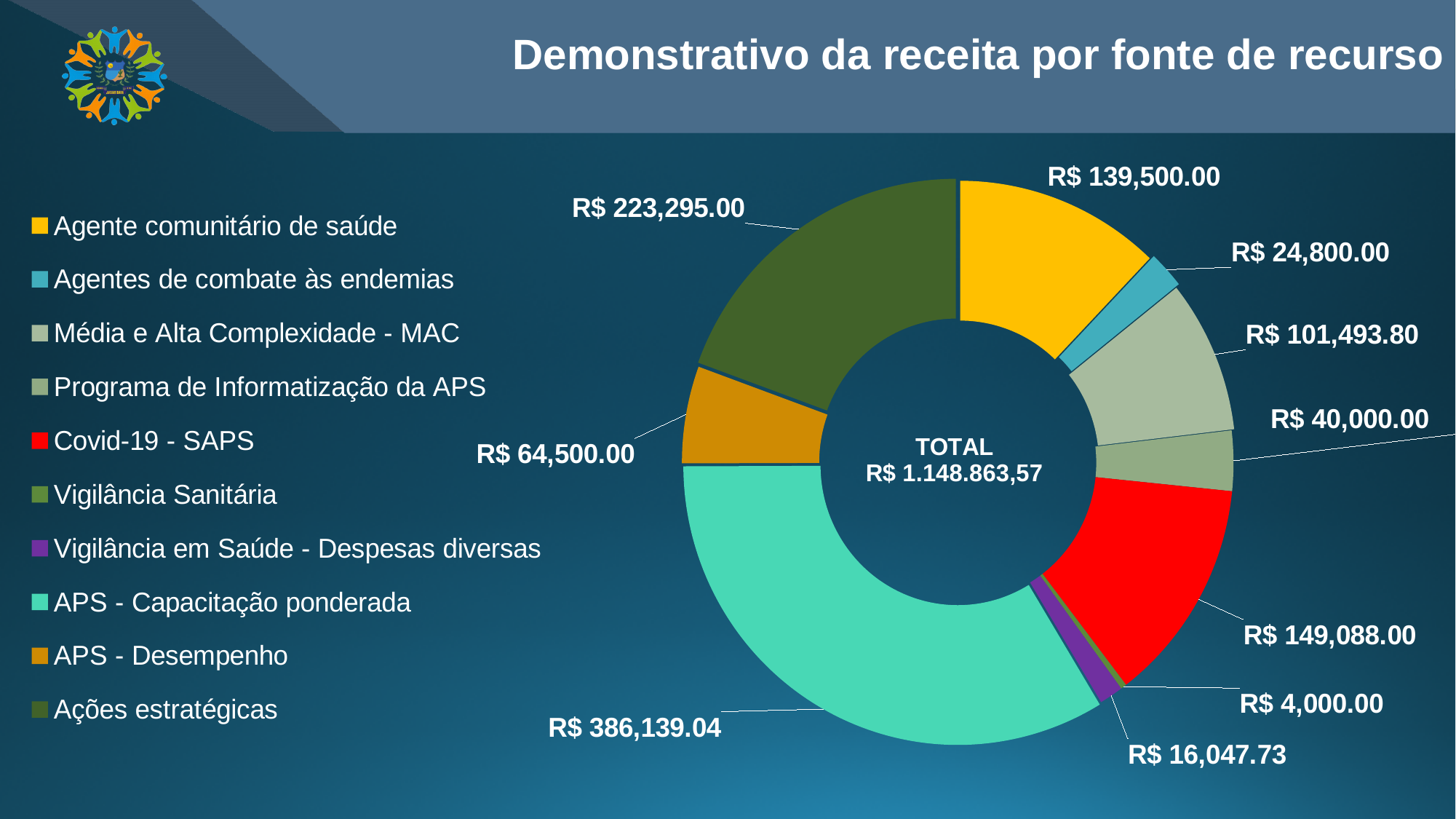
What is the value for Agente comunitário de saúde? R$ 139,500.00 What is the value for APS - Desempenho? R$ 64,500.00 What is the value for Covid-19 - SAPS? R$ 149,088.00 What total is shown in the centre of the chart? R$ 1.148.863,57 What type of chart is shown on the slide? Doughnut (pie) chart Which category has the largest value? APS - Capacitação ponderada What is the value for Vigilância em Saúde - Despesas diversas? R$ 16,047.73 What is the title of the slide? Demonstrativo da receita por fonte de recurso Which category has the smallest value? Vigilância Sanitária How many categories does the chart show? 10 Which is larger, Covid-19 - SAPS or Agente comunitário de saúde? Covid-19 - SAPS What is the difference between Ações estratégicas and APS - Desempenho? R$ 158,795.00